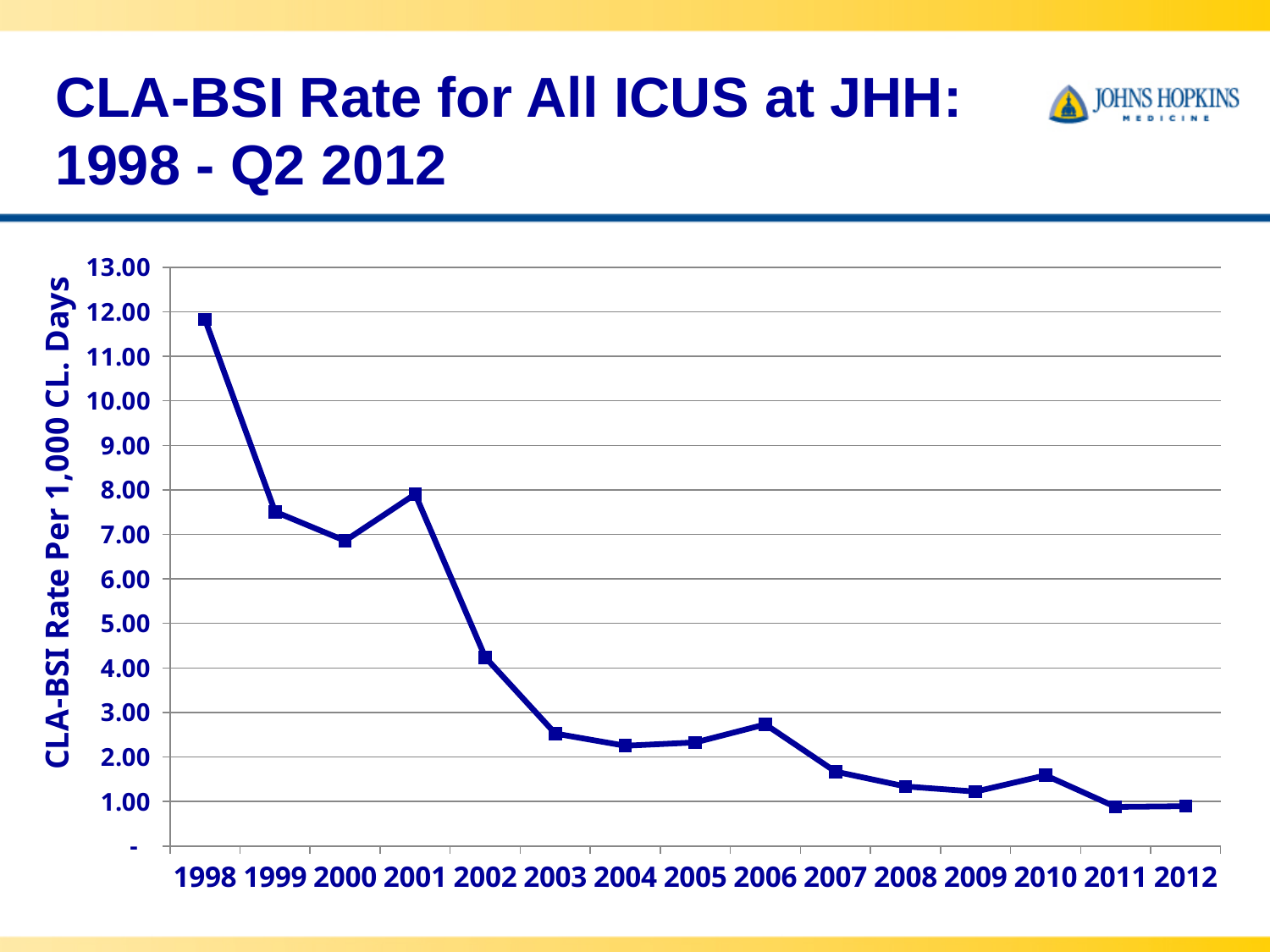
How many years are plotted on the x axis? 15 Is the value for 1998 greater or less than 11.00? greater Is the value for 2002 greater or less than 4.00? greater What kind of chart is shown on the slide? Line chart Is the value for 2003 greater or less than 3.00? less Overall, does the CLA-BSI rate rise or fall from 1998 to 2012? Fall Which year has the higher CLA-BSI rate, 2006 or 2007? 2006 Which year has the highest CLA-BSI rate? 1998 Which year has the higher CLA-BSI rate, 2000 or 2001? 2001 What is the label of the y axis? CLA-BSI Rate Per 1,000 CL. Days